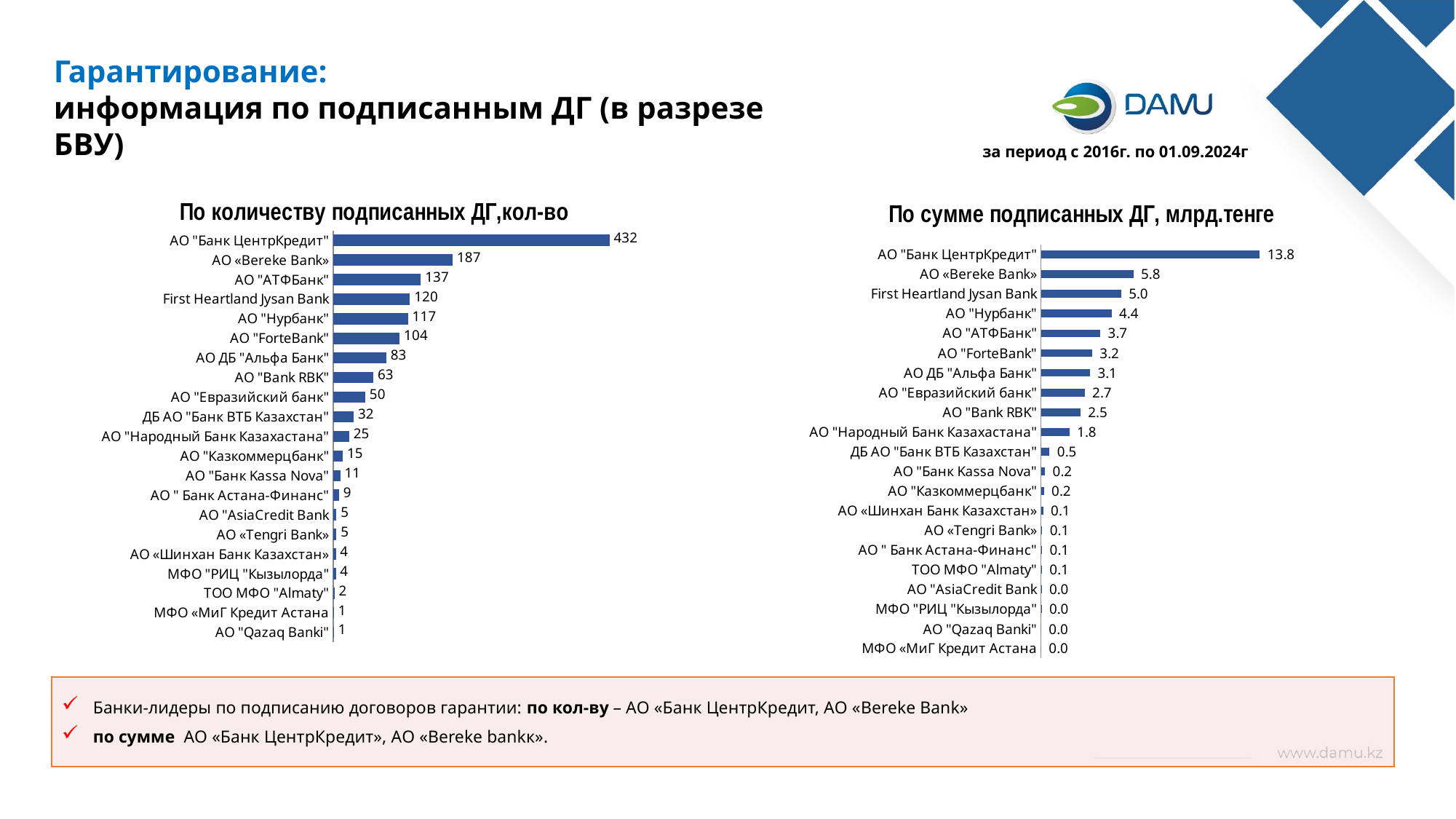
In the chart "По сумме подписанных ДГ, млрд.тенге", which is larger: АО "АТФБанк" or АО "ForteBank"? АО "АТФБанк" In the chart "По количеству подписанных ДГ,кол-во", which is larger: АО "Нурбанк" or First Heartland Jysan Bank? First Heartland Jysan Bank In the chart "По сумме подписанных ДГ, млрд.тенге", what is the value for АО «Bereke Bank»? 5.8 In the chart "По количеству подписанных ДГ,кол-во", what is the difference between АО «Bereke Bank» and АО "АТФБанк"? 50 In the chart "По сумме подписанных ДГ, млрд.тенге", which category has the highest value? АО "Банк ЦентрКредит" In the chart "По сумме подписанных ДГ, млрд.тенге", what is the value for АО "Народный Банк Казахастана"? 1.8 How many categories are shown in the chart "По количеству подписанных ДГ,кол-во"? 21 In the chart "По количеству подписанных ДГ,кол-во", which category has the highest value? АО "Банк ЦентрКредит" In the chart "По сумме подписанных ДГ, млрд.тенге", what is the difference between АО "Банк ЦентрКредит" and АО «Bereke Bank»? 8.0 What type of chart is "По сумме подписанных ДГ, млрд.тенге"? Bar chart In the chart "По количеству подписанных ДГ,кол-во", what is the value for АО "Банк ЦентрКредит"? 432 In the chart "По количеству подписанных ДГ,кол-во", what is the value for АО "ForteBank"? 104